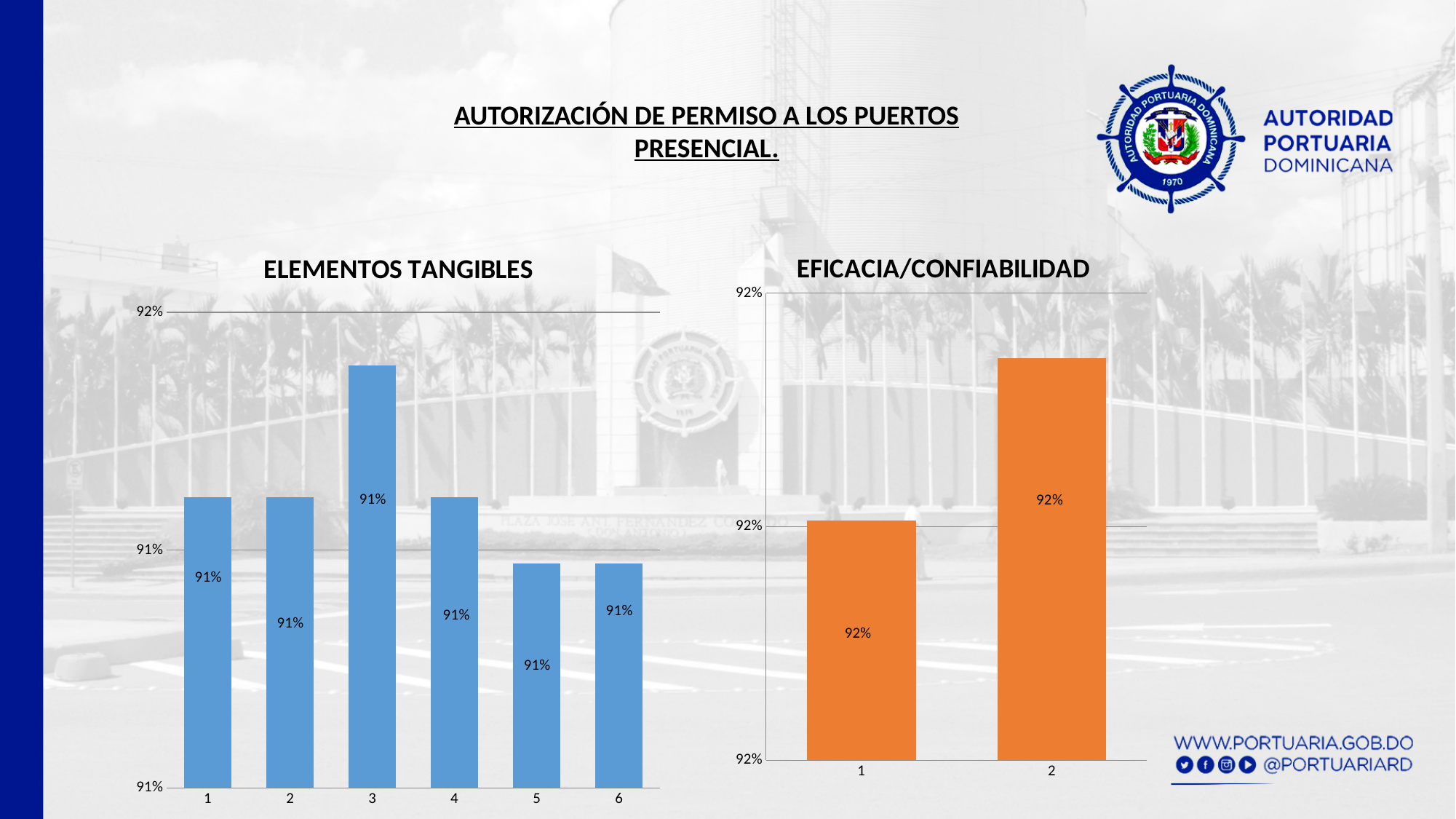
In the ELEMENTOS TANGIBLES chart, what is the value labelled for category 6? 91% What colour are the bars in the EFICACIA/CONFIABILIDAD chart? Orange How many categories are shown in the ELEMENTOS TANGIBLES chart? 6 In the ELEMENTOS TANGIBLES chart, what is the value labelled for category 3? 91% In the EFICACIA/CONFIABILIDAD chart, what is the value labelled for category 1? 92% What type of chart is the ELEMENTOS TANGIBLES chart? Bar chart In the ELEMENTOS TANGIBLES chart, which bar is taller, category 3 or category 5? Category 3 In the EFICACIA/CONFIABILIDAD chart, what is the value labelled for category 2? 92% What is the title of the chart on the left side of the slide? ELEMENTOS TANGIBLES In the EFICACIA/CONFIABILIDAD chart, which category has the taller bar? 2 In the ELEMENTOS TANGIBLES chart, which category has the tallest bar? 3 How many categories are shown in the EFICACIA/CONFIABILIDAD chart? 2